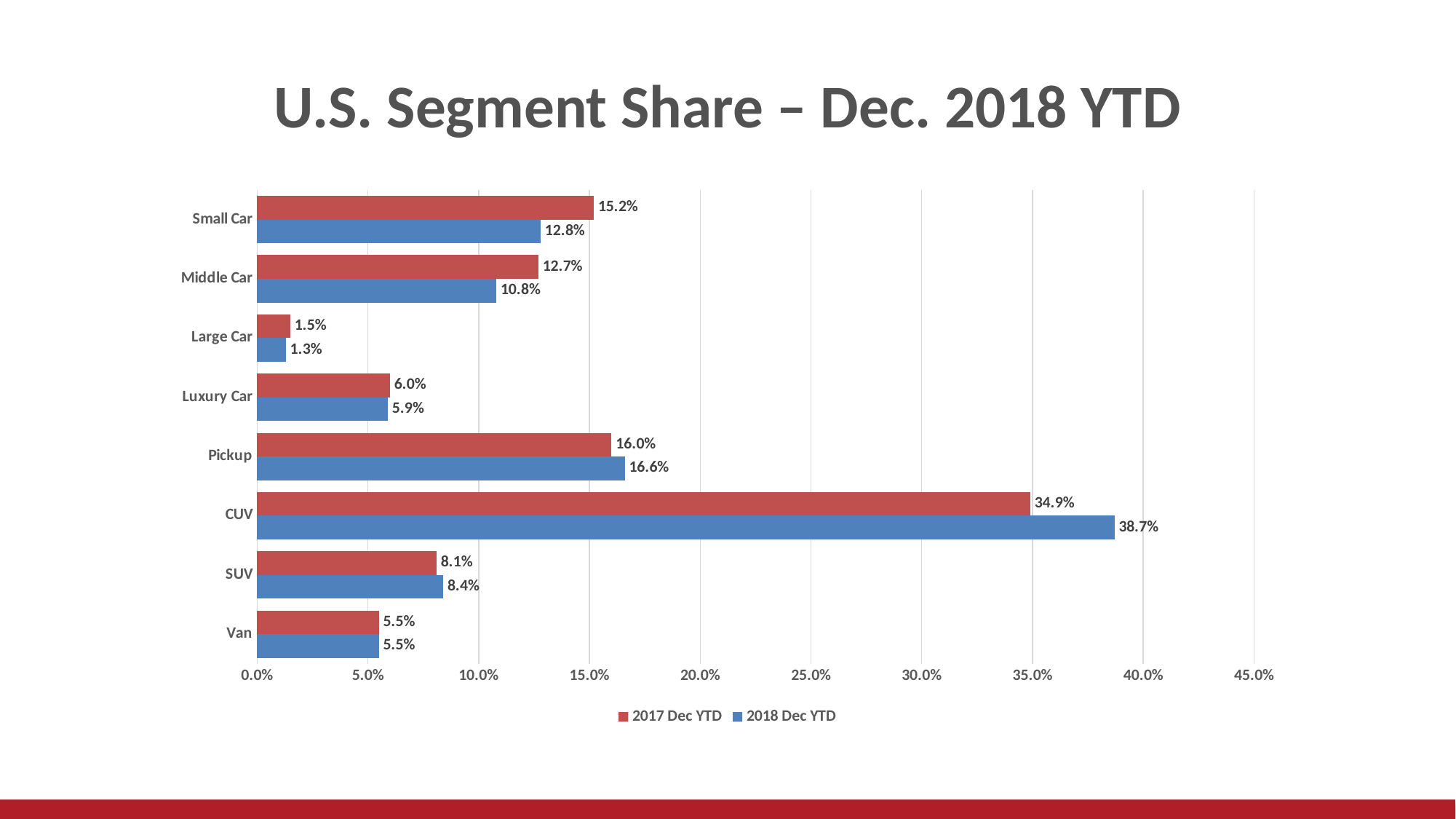
How many series does the legend list? 2 Which segment has the highest 2018 Dec YTD share? CUV How many segments are shown on the chart? 8 What kind of chart is shown on the slide? Bar chart Which is larger for Middle Car: the 2017 Dec YTD share or the 2018 Dec YTD share? 2017 Dec YTD What is the difference between the 2017 Dec YTD and 2018 Dec YTD share for Small Car? 2.4% What is the 2018 Dec YTD segment share for Pickup? 16.6% What is the difference between the 2018 Dec YTD and 2017 Dec YTD share for CUV? 3.8% What is the 2018 Dec YTD segment share for CUV? 38.7% Is the 2018 Dec YTD share for CUV greater or less than 35.0%? greater What is the 2017 Dec YTD segment share for Small Car? 15.2% Which segment has the lowest 2017 Dec YTD share? Large Car